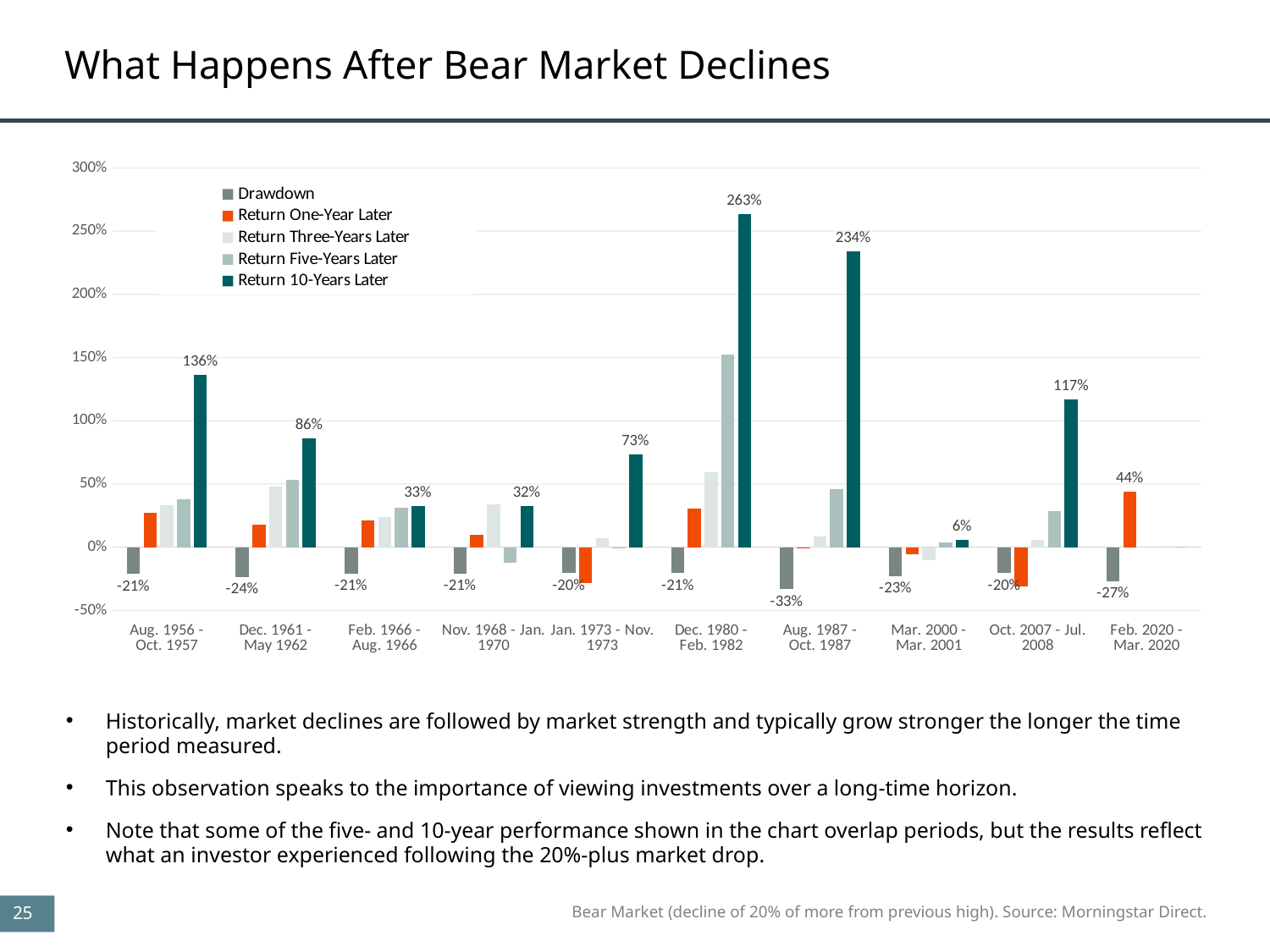
Which bear market period has the highest Return 10-Years Later? Dec. 1980 - Feb. 1982 What kind of chart is shown on the slide? Bar chart How many bear market periods are shown on the x axis? 10 What is the Drawdown for the Aug. 1987 - Oct. 1987 period? -33% What is the Return 10-Years Later for the Mar. 2000 - Mar. 2001 period? 6% Is the Return One-Year Later for Dec. 1980 - Feb. 1982 greater or less than 50%? less What is the Return 10-Years Later for the Dec. 1980 - Feb. 1982 bear market? 263% How many series does the legend list? 5 Which has the larger Return 10-Years Later: Aug. 1956 - Oct. 1957 or Oct. 2007 - Jul. 2008? Aug. 1956 - Oct. 1957 What is the difference between the Return 10-Years Later for Dec. 1980 - Feb. 1982 and for Aug. 1987 - Oct. 1987? 29% Is the Return Five-Years Later for Dec. 1980 - Feb. 1982 greater or less than 100%? greater Which bear market period has the lowest (most negative) Drawdown? Aug. 1987 - Oct. 1987